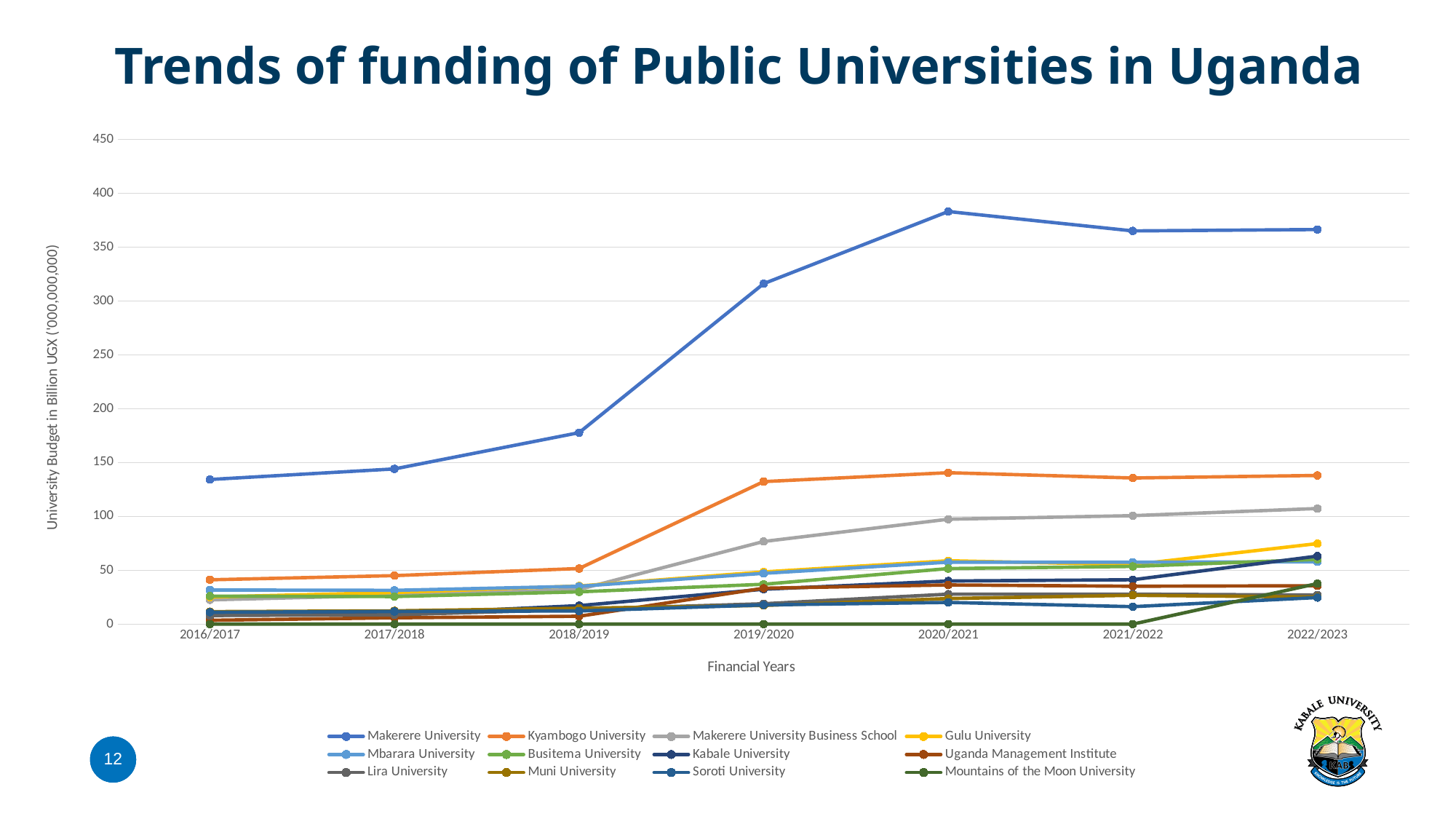
Does the budget of Makerere University rise or fall from 2016/2017 to 2020/2021? rises Is the value for Makerere University in 2016/2017 greater or less than 150? less What is the title of the chart? Trends of funding of Public Universities in Uganda What kind of chart is shown on the slide? line chart Is the value for Makerere University Business School in 2019/2020 greater or less than 50? greater How many universities (series) does the legend list? 12 In 2022/2023, which is larger: the budget of Kyambogo University or of Makerere University Business School? Kyambogo University How many financial years are shown on the x axis? 7 Is the value for Kyambogo University in 2019/2020 greater or less than 100? greater Which university has the highest budget in 2022/2023? Makerere University Which university has the lowest budget in 2020/2021? Mountains of the Moon University